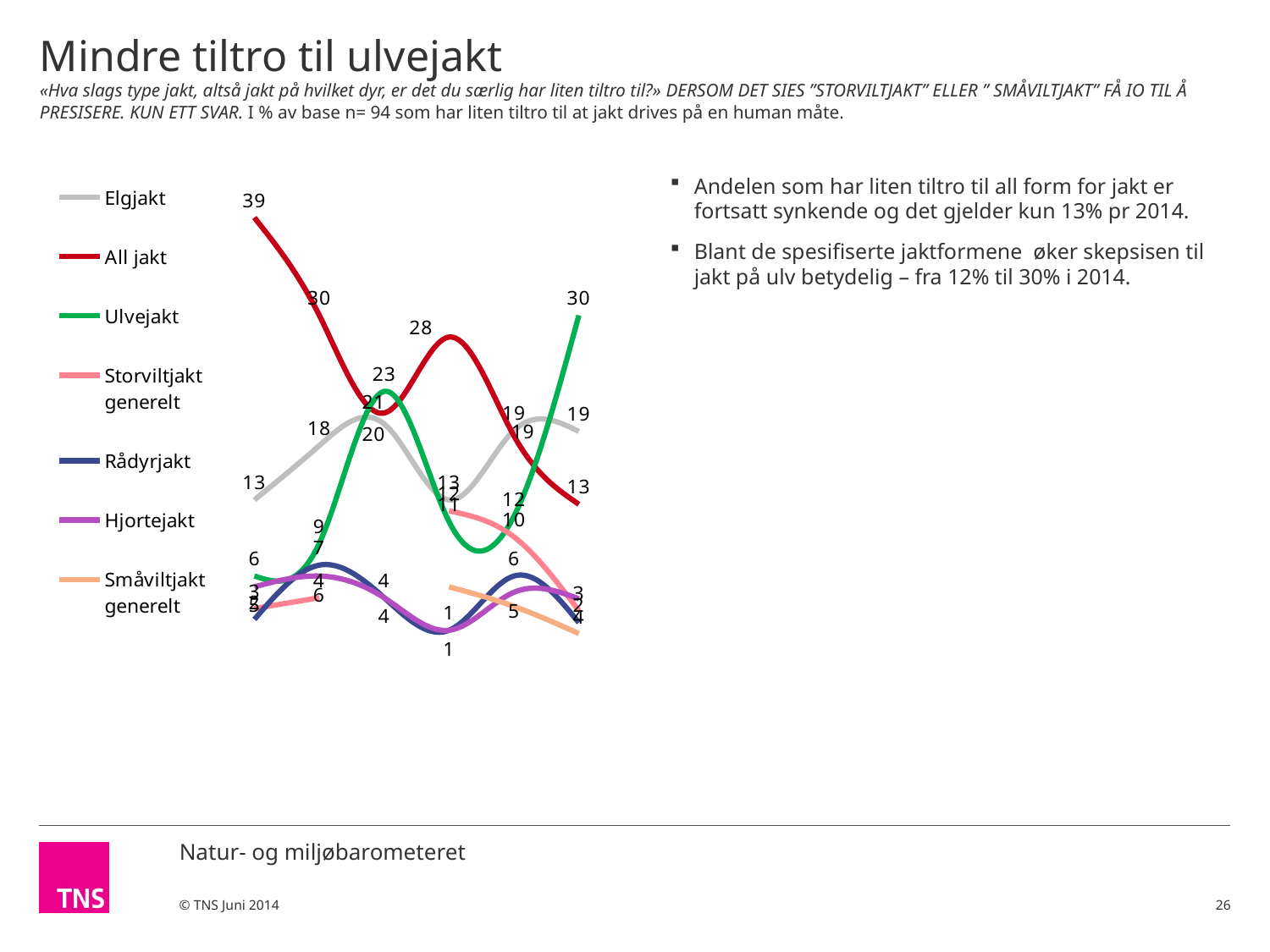
What is the difference between the first value of All jakt (39) and its last value (13)? 26 Which series is drawn in green? Ulvejakt Does the All jakt series overall rise or fall from left to right? fall At the rightmost point, which series is higher: Ulvejakt or All jakt? Ulvejakt What is the first (leftmost) value shown for the All jakt series? 39 What is the last (rightmost) value shown for the All jakt series? 13 Which series reaches the highest value anywhere on the chart? All jakt What kind of chart is shown on the slide? line chart What is the last (rightmost) value shown for the Ulvejakt series? 30 What is the difference between the rightmost values of Ulvejakt (30) and All jakt (13)? 17 How many series does the legend list? 7 What is the first entry listed in the legend? Elgjakt